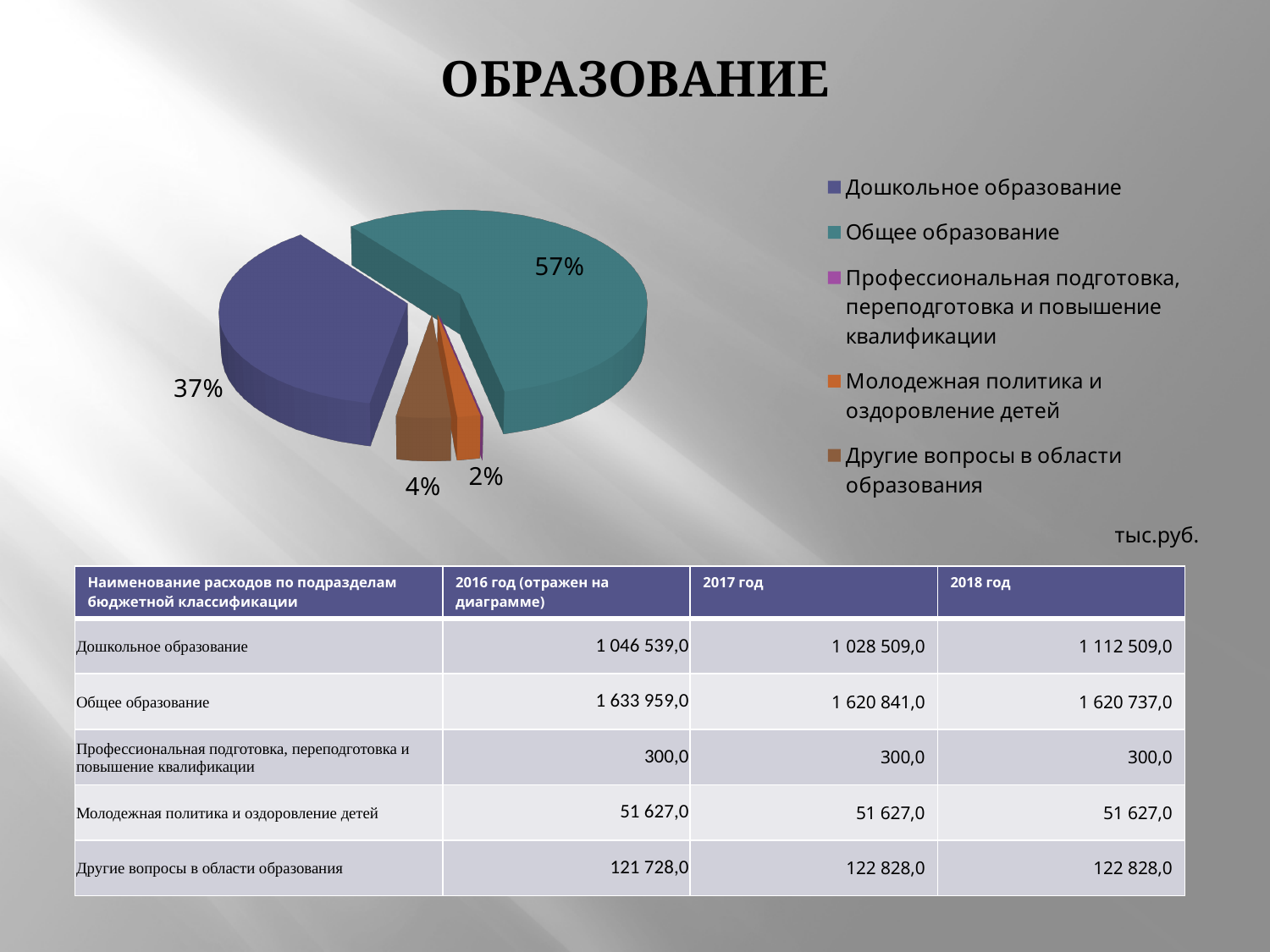
How many categories does the legend list? 5 Is the share for Общее образование greater or less than 50%? greater What share of the pie does Общее образование have? 57% What share of the pie does Молодежная политика и оздоровление детей have? 2% How many percentage labels are printed on the pie? 4 Which is larger, the slice for Дошкольное образование or the slice for Общее образование? Общее образование What kind of chart is shown on the slide? pie chart What is the difference in percentage points between the Общее образование slice and the Дошкольное образование slice? 20 What share of the pie does Дошкольное образование have? 37% What is the title of the slide containing the chart? ОБРАЗОВАНИЕ Which category has the largest slice of the pie? Общее образование